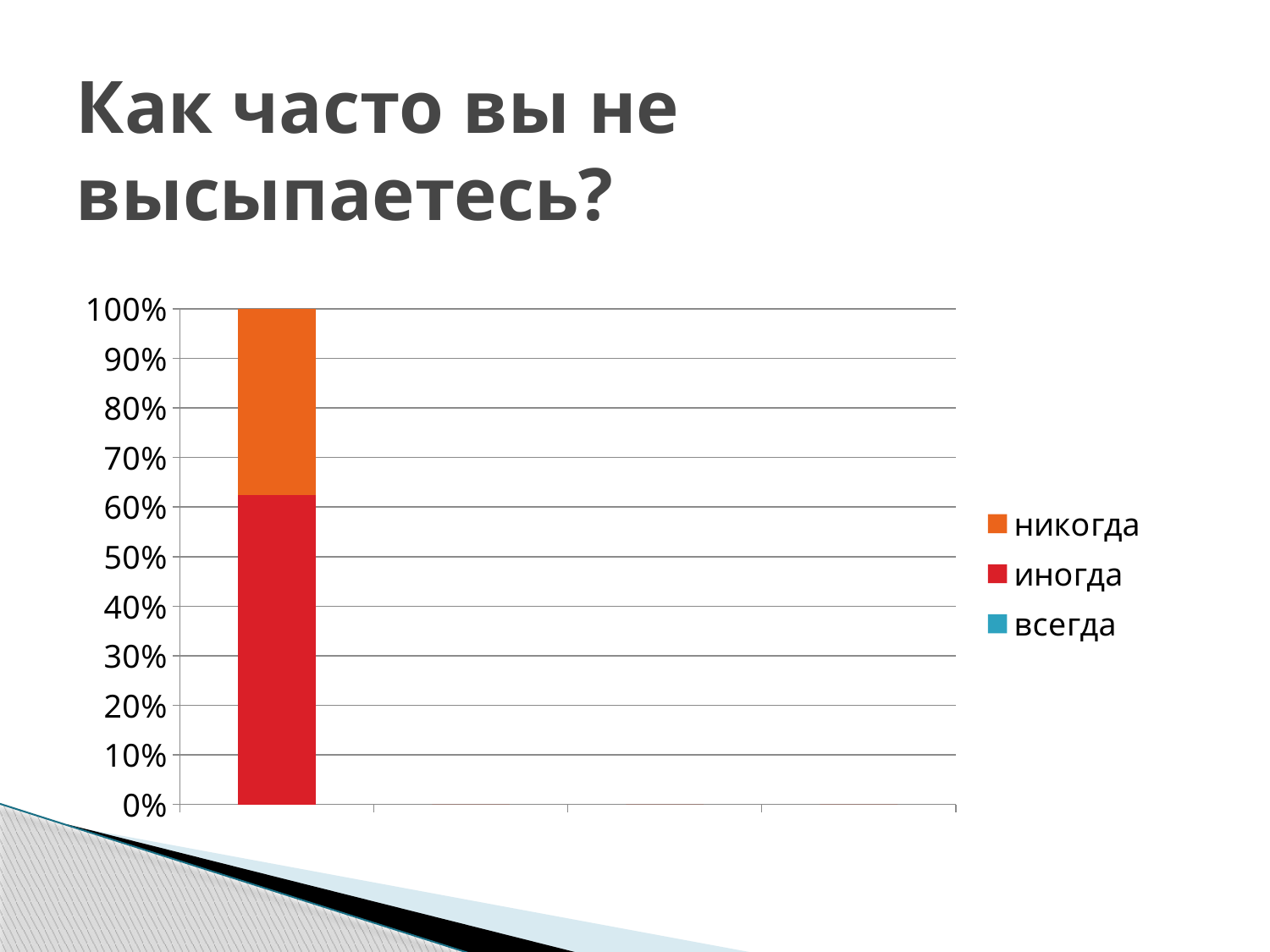
Is the value for "иногда" greater or less than 30%? greater Which series takes up the smallest share of the stacked bar? всегда Is the value for "никогда" greater or less than 50%? less How many series does the legend list? 3 Which series takes up the largest share of the stacked bar? иногда Is the value for "иногда" greater or less than 50%? greater What is the title of the slide above the chart? Как часто вы не высыпаетесь? Which is larger, the segment for "иногда" or the segment for "никогда"? иногда How many stacked bars are plotted in the chart? 1 What kind of chart is shown on the slide? stacked bar chart Which colour represents the series "иногда" in the chart? red What is the total height of the stacked bar on the axis? 100%